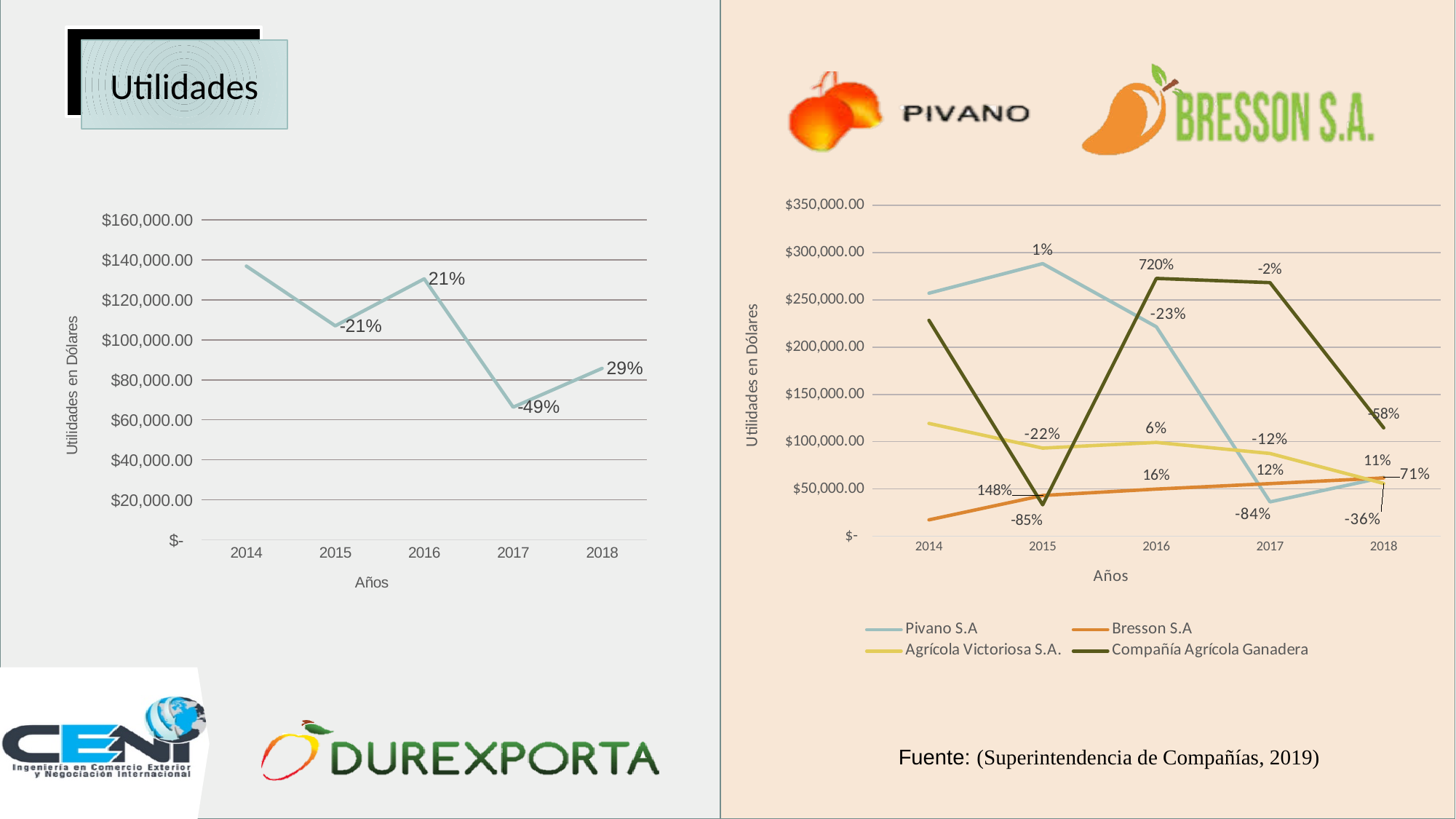
How many series does the legend of the right chart list? 4 In the left chart, what percentage label is shown for 2017? -49% How many years are shown on the x axis of the left chart? 5 What type of chart is the left chart on the slide? line chart In the right chart, which series has the highest value in 2015? Pivano S.A In the left chart, is the value for 2017 greater or less than $80,000.00? less In the right chart, what percentage label is shown for Compañía Agrícola Ganadera in 2016? 720% In the right chart, is the value for Pivano S.A in 2015 greater or less than $250,000.00? greater In the left chart, what percentage label is shown for 2016? 21% In the left chart, which year has the highest value? 2014 What is the y-axis title of the right chart? Utilidades en Dólares In the right chart, what percentage label is shown for Pivano S.A in 2017? -84%